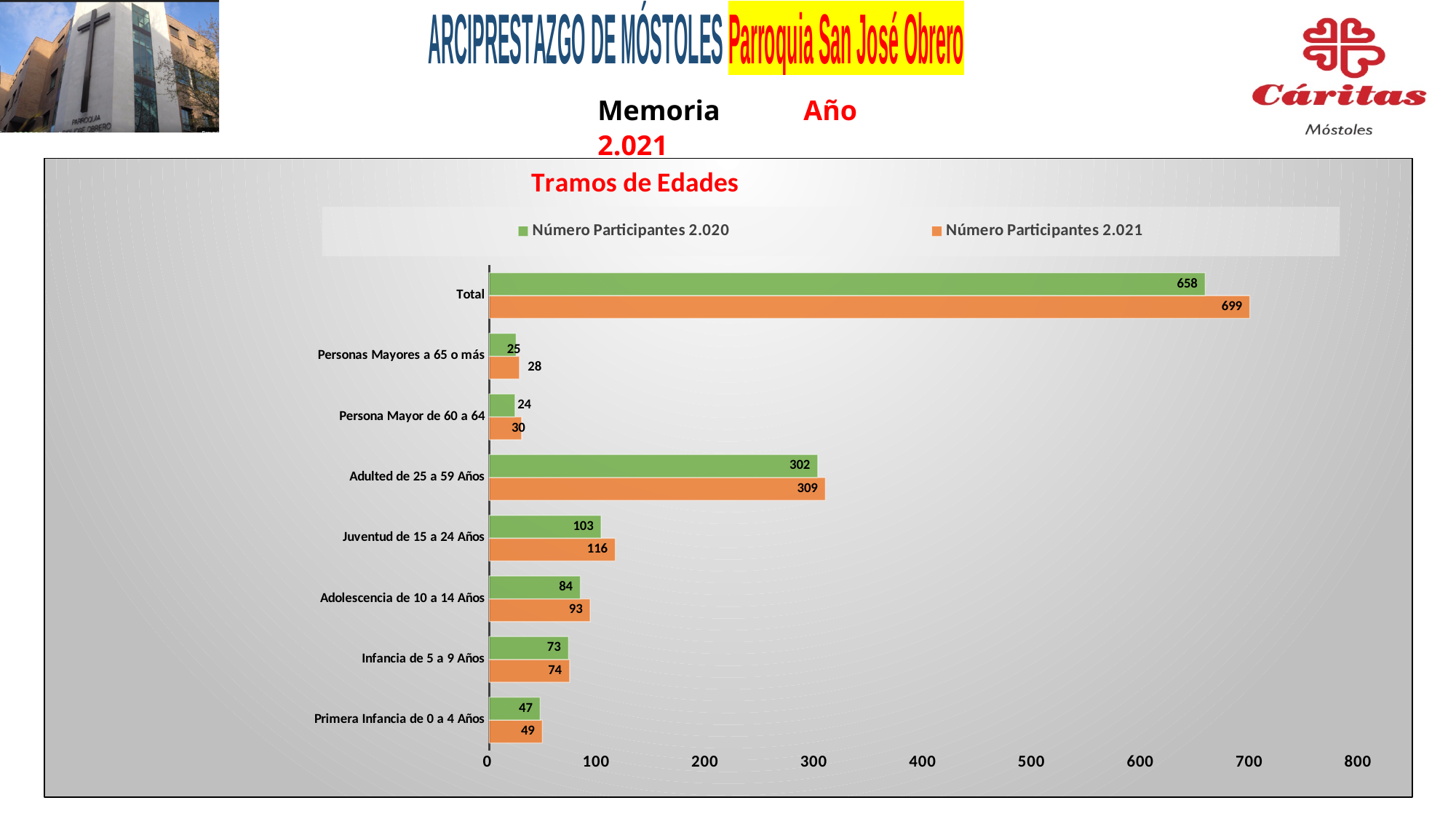
What is the value of Número Participantes 2.021 for Adulted de 25 a 59 Años? 309 What is the title of the chart? Tramos de Edades Excluding the Total bar, which category has the highest value for Número Participantes 2.020? Adulted de 25 a 59 Años What is the difference between Número Participantes 2.021 and Número Participantes 2.020 for Juventud de 15 a 24 Años? 13 Which category has the lowest value for Número Participantes 2.021? Personas Mayores a 65 o más What is the value of Número Participantes 2.020 for Juventud de 15 a 24 Años? 103 What kind of chart is shown on the slide? Bar chart What is the Total value for Número Participantes 2.021? 699 How many categories are shown on the y axis of the chart? 8 Which is larger for Adolescencia de 10 a 14 Años: Número Participantes 2.020 or Número Participantes 2.021? Número Participantes 2.021 How many series does the legend list? 2 What is the difference between the Total values for Número Participantes 2.021 and Número Participantes 2.020? 41